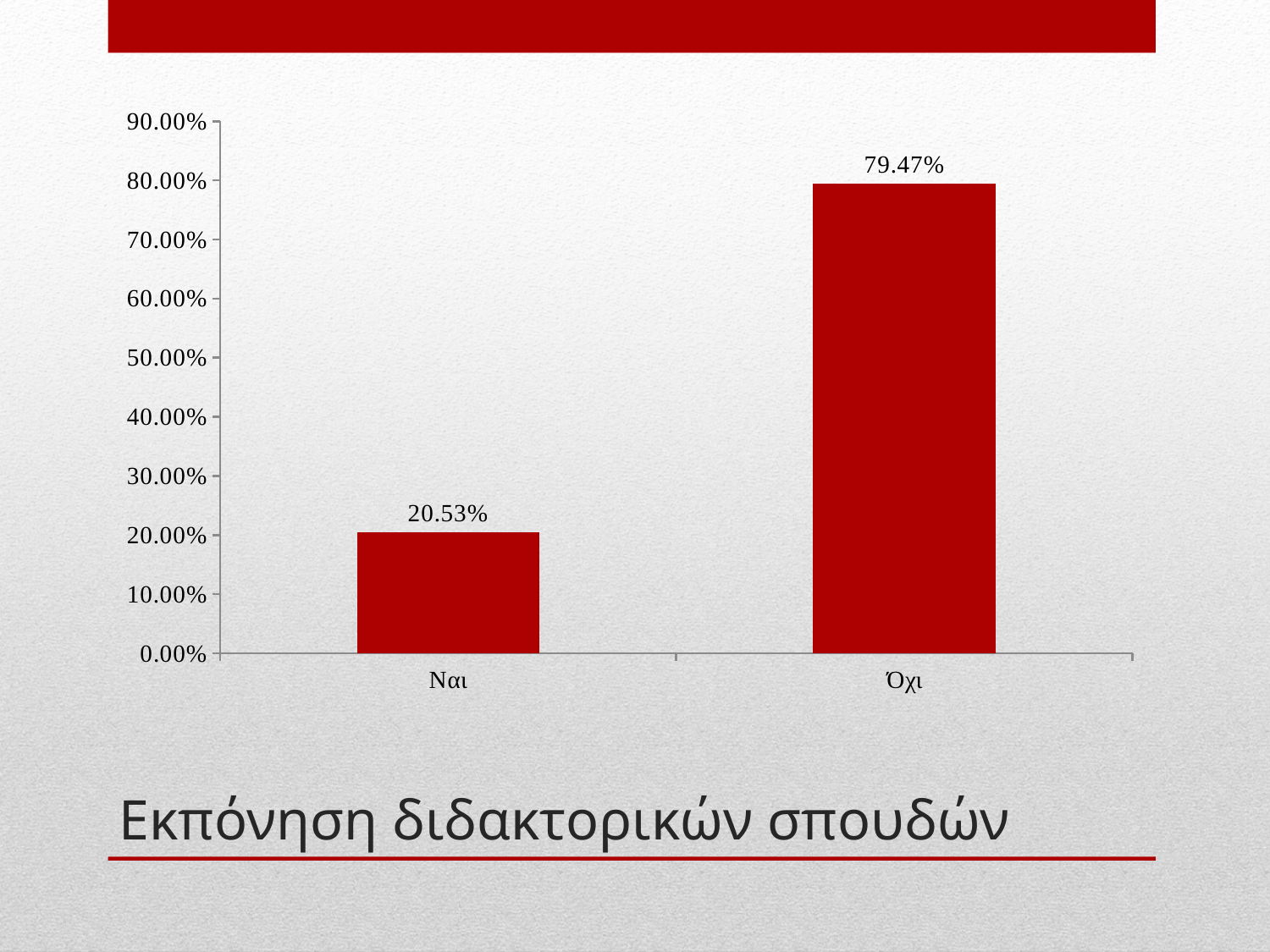
What is the title text shown below the chart? Εκπόνηση διδακτορικών σπουδών Is the value for Ναι greater or less than 30.00%? less What is the value for Ναι? 20.53% Which category has the highest value? Όχι What is the value for Όχι? 79.47% Is the value for Όχι greater or less than 70.00%? greater What is the total of the two values shown? 100.00% Which category has the lowest value? Ναι Which is larger, the value for Ναι or the value for Όχι? Όχι What is the difference between the values for Όχι and Ναι? 58.94% How many categories are shown on the x axis? 2 What kind of chart is shown on the slide? bar chart